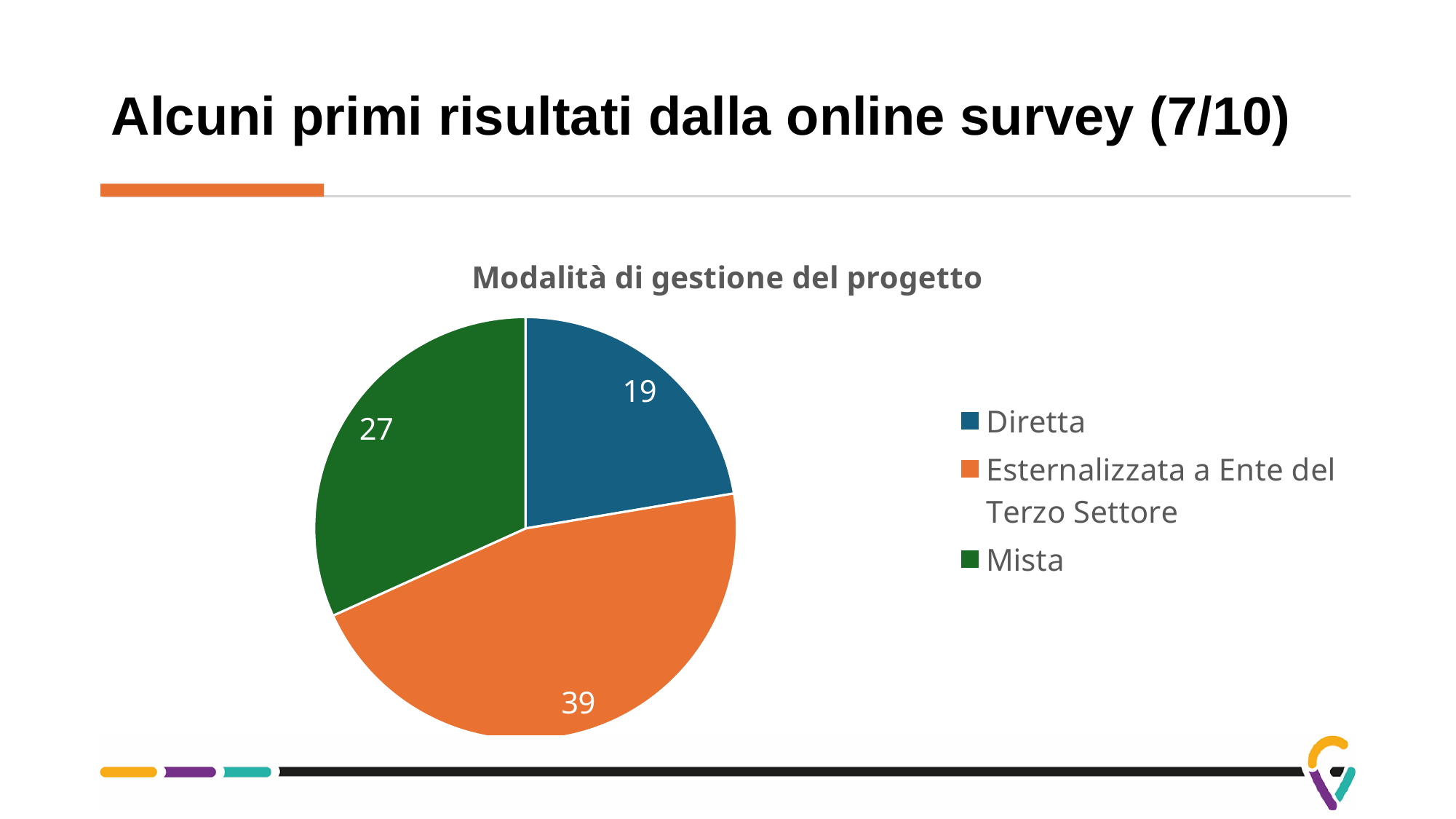
Which is larger, the value for Mista or the value for Diretta? Mista What type of chart is shown on the slide? pie chart Which category has the smallest slice? Diretta What is the title of the chart? Modalità di gestione del progetto What is the difference between the values for Esternalizzata a Ente del Terzo Settore and Mista? 12 What is the difference between the values for Mista and Diretta? 8 What is the total of all slices in the pie chart? 85 How many categories does the pie chart have? 3 Which category has the largest slice? Esternalizzata a Ente del Terzo Settore What is the value for Mista? 27 What is the value for Esternalizzata a Ente del Terzo Settore? 39 What is the value for Diretta? 19